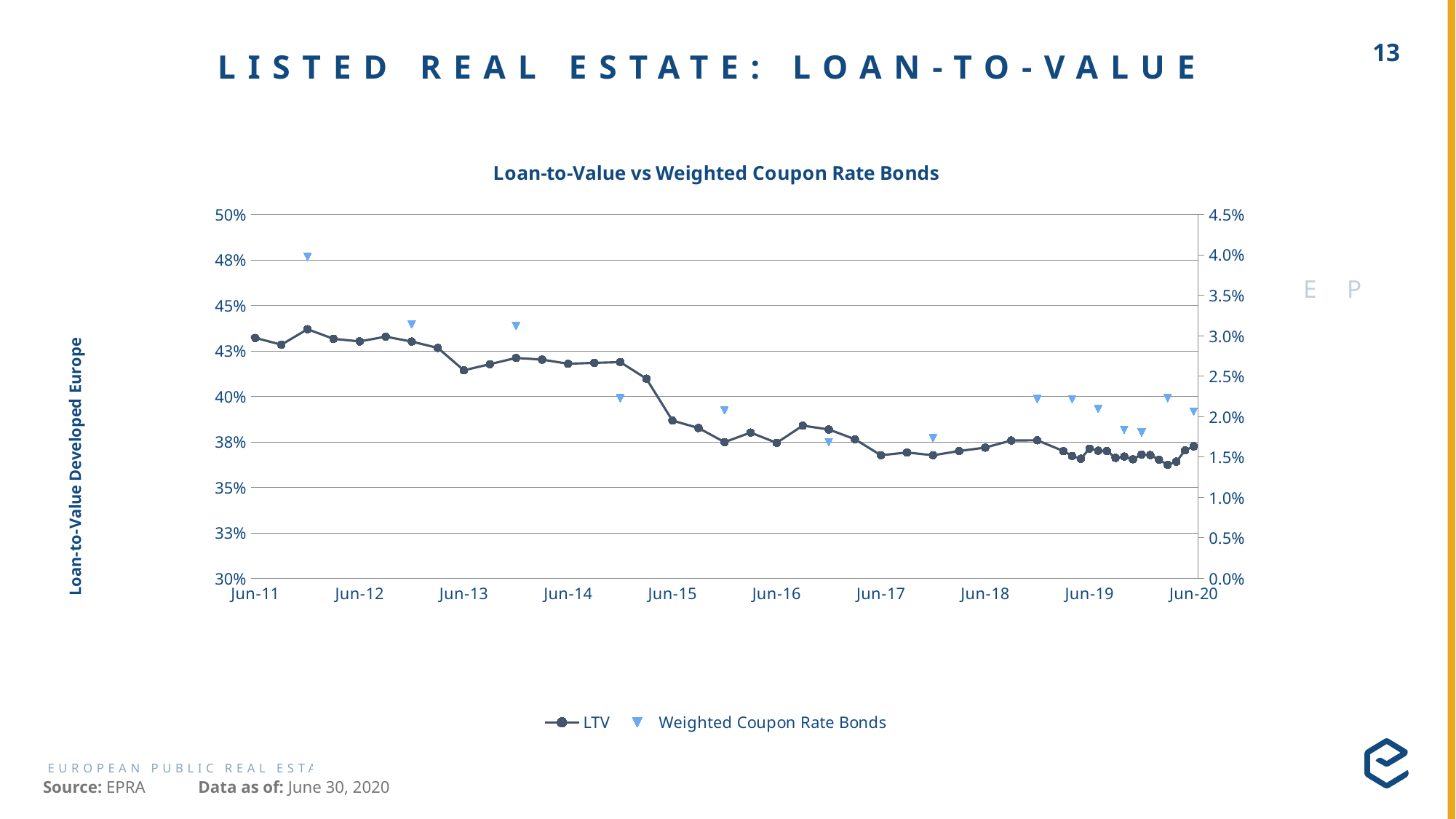
What is the label on the left vertical axis? Loan-to-Value Developed Europe What is the title of the chart? Loan-to-Value vs Weighted Coupon Rate Bonds How many date labels are shown on the x axis? 10 Is the LTV value at Jun-11 greater or less than 40%? greater What type of chart is shown on the slide? Line chart Is the LTV value at Jun-17 greater or less than 40%? less Does the LTV series rise or fall overall from Jun-11 to Jun-20? Fall Is the LTV value at Jun-20 greater or less than 40%? less How many series does the legend list? 2 Which is higher, the LTV value at Jun-12 or at Jun-20? Jun-12 Which is higher, the LTV value at Jun-14 or at Jun-16? Jun-14